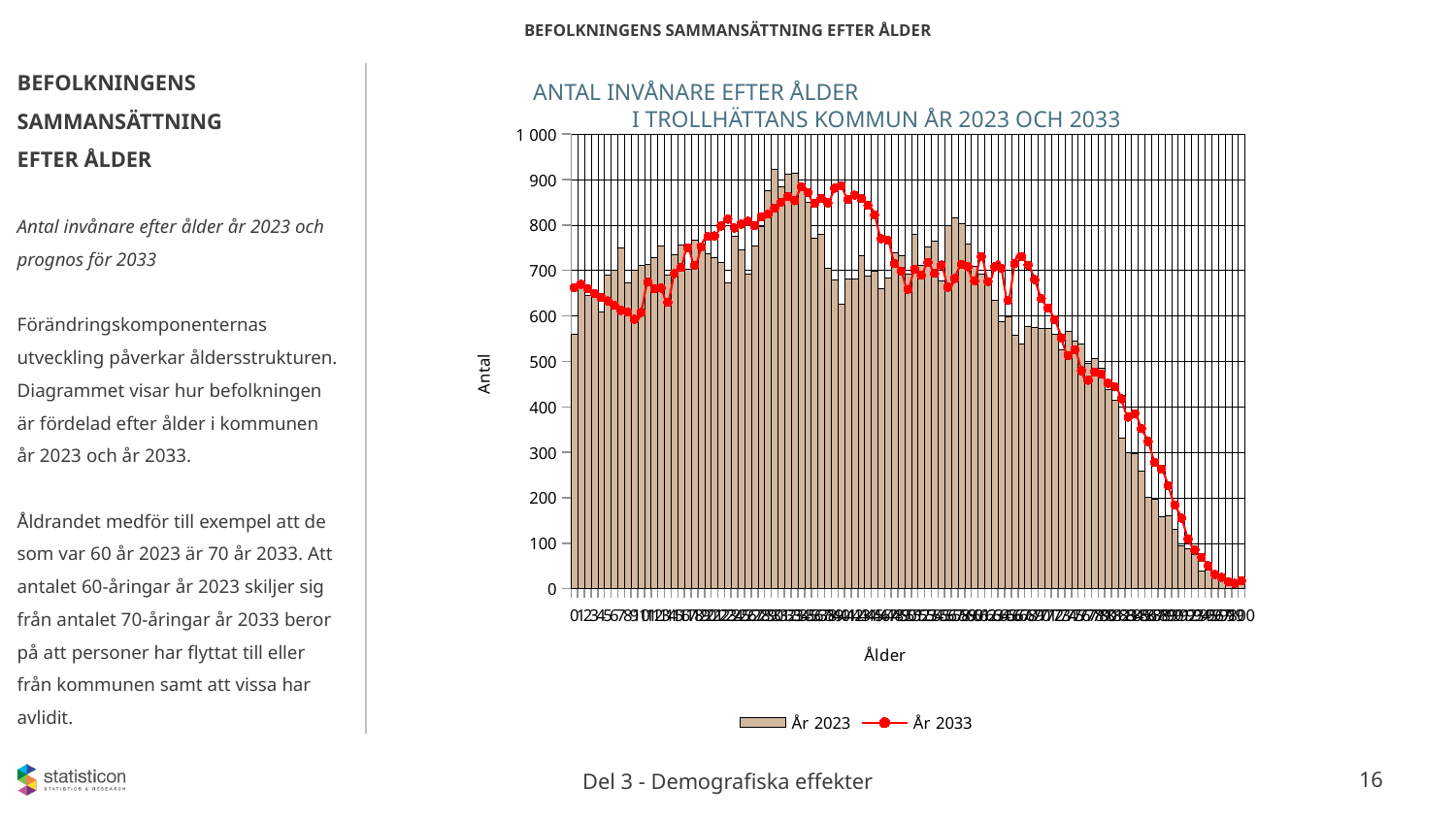
Is the value for År 2023 at age 100 greater or less than 100? less Is the value for År 2033 at age 0 greater or less than 600? greater Which series is drawn as bars in the chart? År 2023 Which series is drawn as a red line with markers in the chart? År 2033 What is the highest value shown on the vertical axis of the chart? 1 000 Is the value for År 2033 at age 100 greater or less than 100? less How many series does the chart legend list? 2 Do the values for År 2033 rise or fall toward the highest ages at the right end of the x axis? fall What kind of chart is shown on the slide? A bar chart with a line series